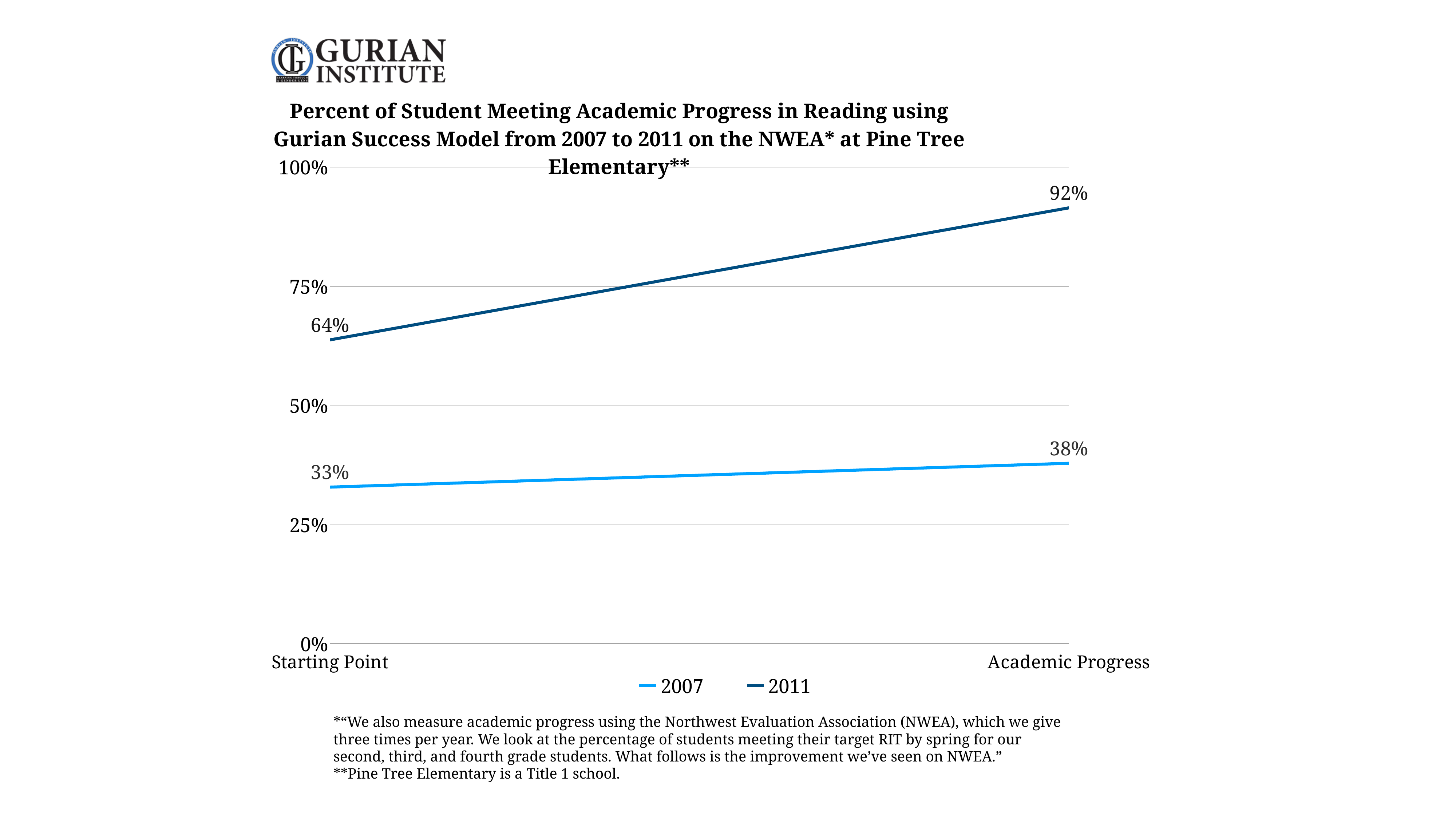
What is the difference between the 2011 and 2007 values at Academic Progress? 54% What is the value for the 2011 series at Academic Progress? 92% What kind of chart is shown on the slide? line chart Which series has the higher value at Starting Point, 2007 or 2011? 2011 How many categories are shown on the x axis? 2 Is the value for the 2011 series at Academic Progress greater or less than 75%? greater How many series does the legend list? 2 What is the value for the 2007 series at Starting Point? 33% Does the 2007 series rise or fall from Starting Point to Academic Progress? rise What is the value for the 2011 series at Starting Point? 64% What is the difference between the 2011 series' Academic Progress value and its Starting Point value? 28% What is the value for the 2007 series at Academic Progress? 38%